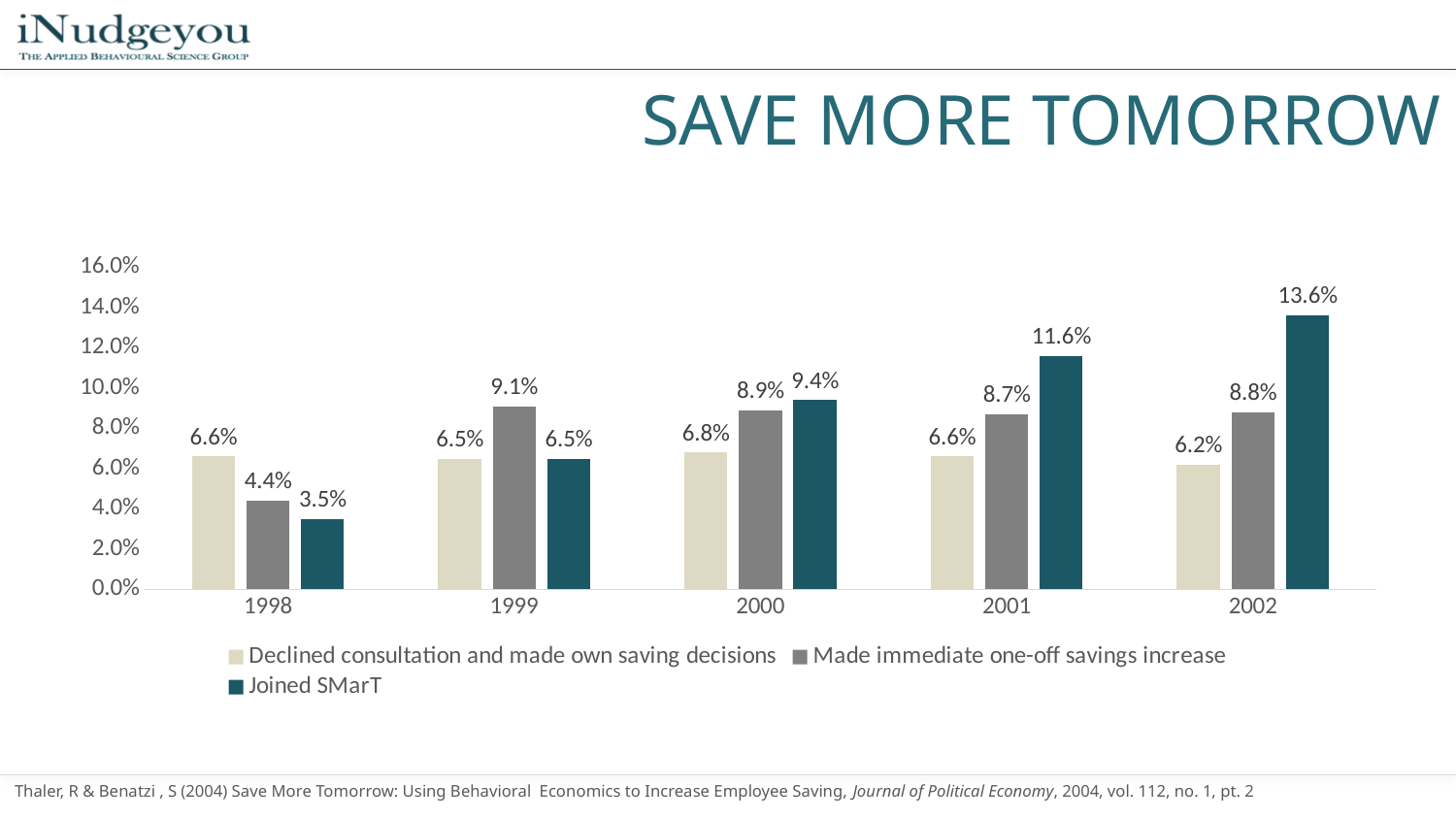
What is the difference between the 'Joined SMarT' rate and the 'Declined consultation and made own saving decisions' rate in 2002? 7.4% What was the saving rate for the 'Made immediate one-off savings increase' group in 2000? 8.9% What is the title of the slide containing the chart? SAVE MORE TOMORROW What was the saving rate for the 'Joined SMarT' group in 2002? 13.6% In 1999, which group had the higher saving rate: 'Made immediate one-off savings increase' or 'Joined SMarT'? Made immediate one-off savings increase In which year was the 'Joined SMarT' saving rate lowest? 1998 In which year was the 'Joined SMarT' saving rate highest? 2002 What kind of chart is shown on the slide? Bar chart How many years are shown on the x axis? 5 Does the 'Joined SMarT' saving rate rise or fall from 1998 to 2002? Rise How many series does the legend list? 3 What was the saving rate for the 'Declined consultation and made own saving decisions' group in 1998? 6.6%